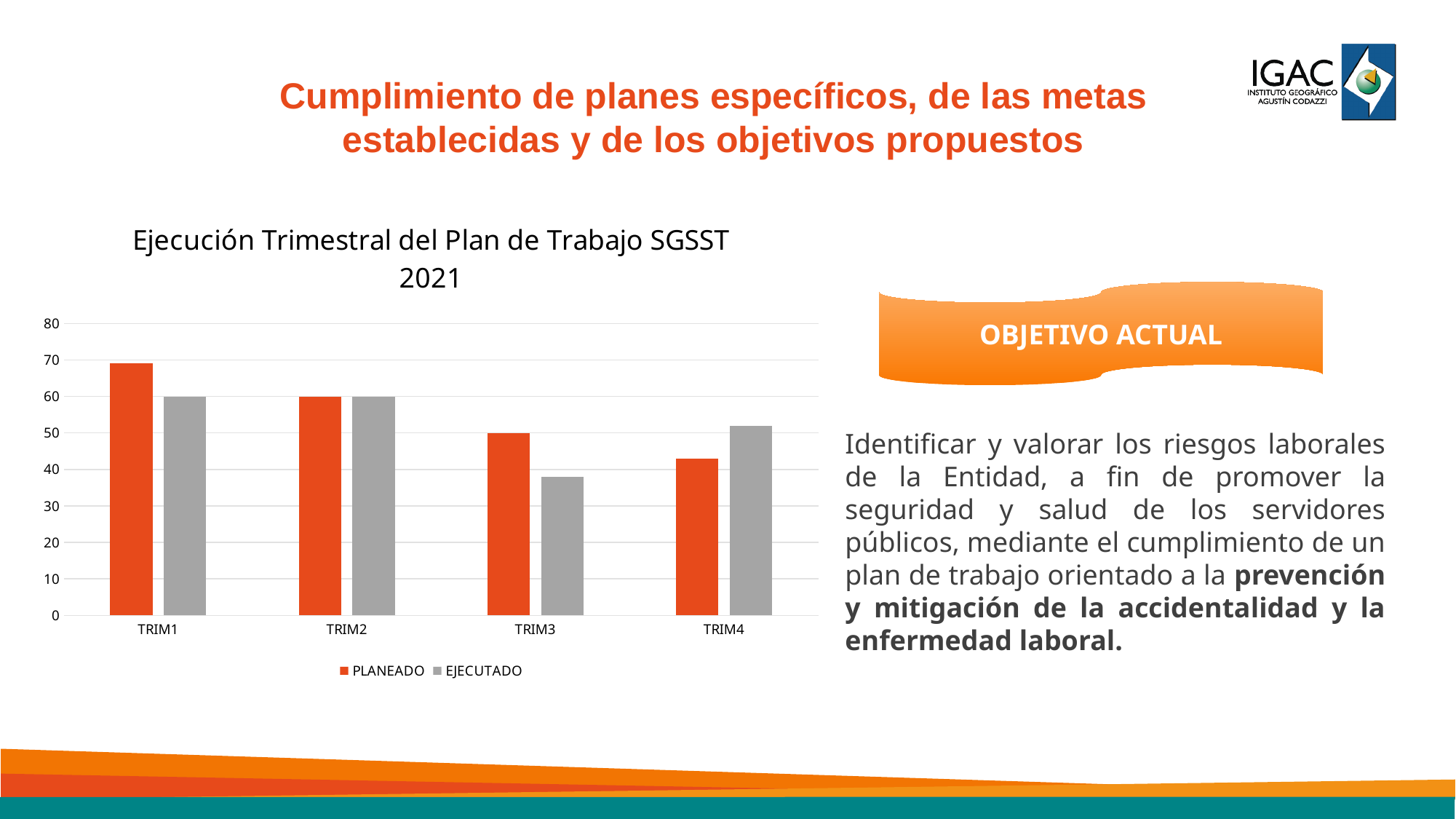
Is the PLANEADO value for TRIM1 greater or less than 60? greater How many quarters (categories) are shown on the x axis? 4 Which quarter has the lowest PLANEADO value? TRIM4 Which quarter has the lowest EJECUTADO value? TRIM3 Which quarter has the highest PLANEADO value? TRIM1 How many series does the chart legend list? 2 What kind of chart is shown on the slide? Bar chart Do the PLANEADO values rise or fall from TRIM1 to TRIM4? fall What is the title of the chart? Ejecución Trimestral del Plan de Trabajo SGSST 2021 Is the PLANEADO value for TRIM4 greater or less than 50? less Is the EJECUTADO value for TRIM3 greater or less than 50? less In TRIM4, which is larger, PLANEADO or EJECUTADO? EJECUTADO